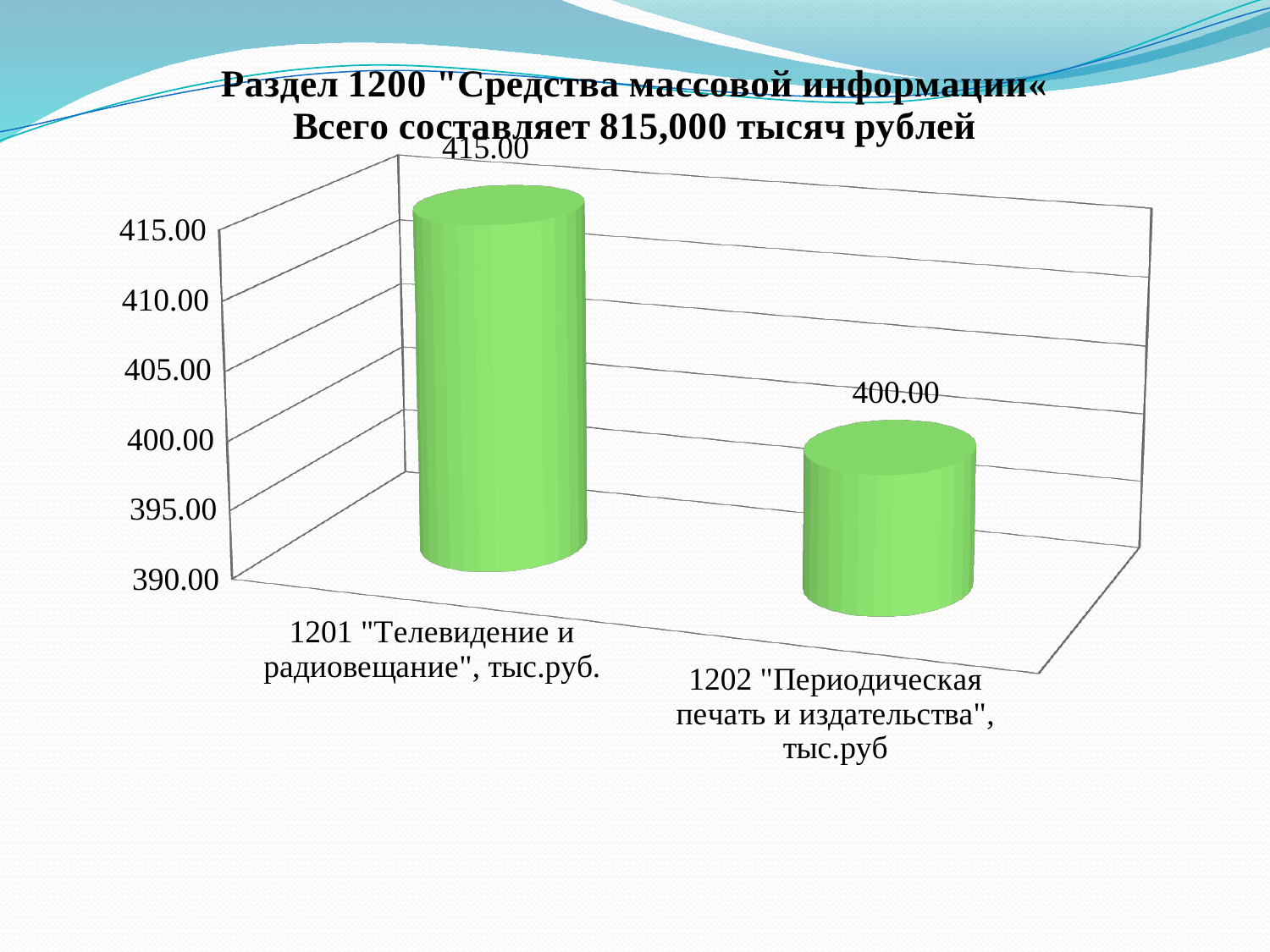
Which is larger: the value for 1201 "Телевидение и радиовещание" or for 1202 "Периодическая печать и издательства"? 1201 "Телевидение и радиовещание" How many categories are shown in the chart? 2 What is the value for 1201 "Телевидение и радиовещание"? 415.00 Do the values rise or fall from left to right along the x axis? fall Which category has the lowest value? 1202 "Периодическая печать и издательства" What is the value for 1202 "Периодическая печать и издательства"? 400.00 What kind of chart is shown on the slide? bar chart Which category has the highest value? 1201 "Телевидение и радиовещание" What is the difference between the values for 1201 "Телевидение и радиовещание" and 1202 "Периодическая печать и издательства"? 15.00 Is the value for 1201 "Телевидение и радиовещание" greater or less than 410.00? greater Is the value for 1202 "Периодическая печать и издательства" greater or less than 405.00? less What total amount does the slide title state for Раздел 1200? 815,000 тысяч рублей